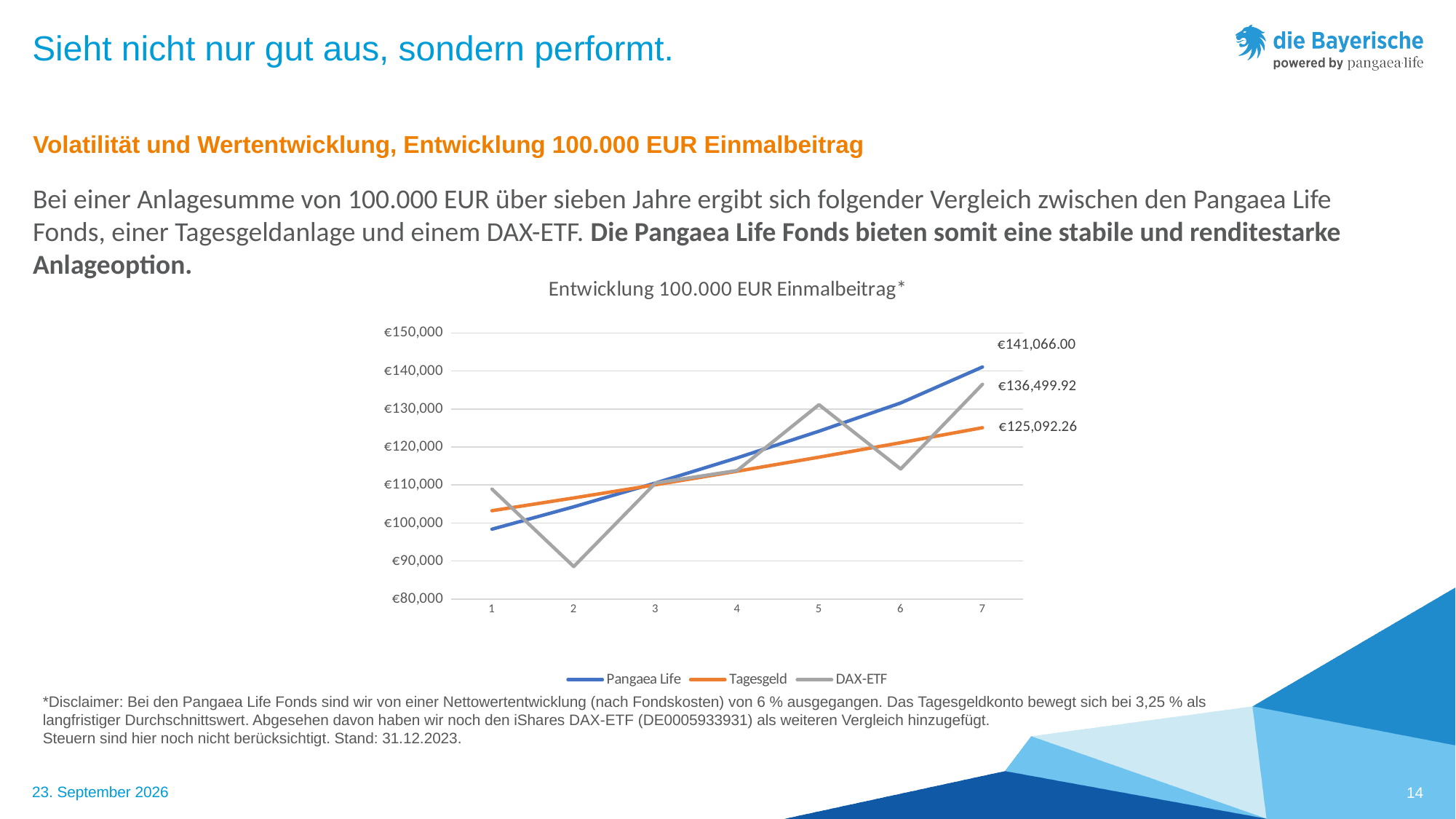
Which series has the highest value at point 7? Pangaea Life What is the value of Tagesgeld at point 7? €125,092.26 How many points are shown along the x axis? 7 What is the value of DAX-ETF at point 7? €136,499.92 What is the difference between the Pangaea Life and DAX-ETF values at point 7? €4,566.08 What is the difference between the Pangaea Life and Tagesgeld values at point 7? €15,973.74 Which series has the lowest value at point 2? DAX-ETF Is the value for DAX-ETF at point 2 greater or less than €100,000? less What is the value of Pangaea Life at point 7? €141,066.00 Is the value for DAX-ETF at point 5 greater or less than €120,000? greater What kind of chart is shown on the slide? line chart How many series does the chart legend list? 3